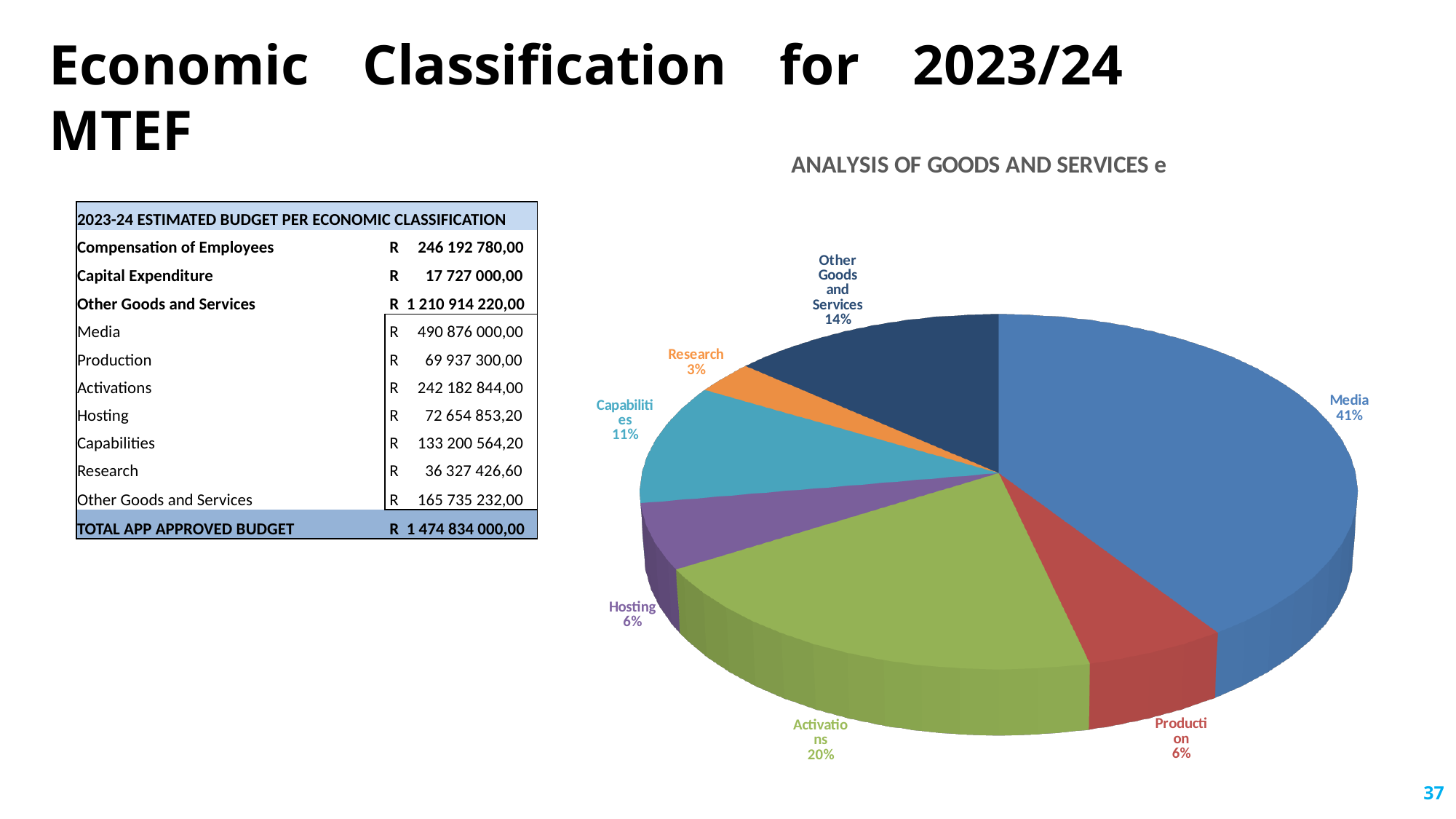
What share of the pie does Activations account for? 20% Which slice of the pie chart is the largest? Media Which slice of the pie chart is the smallest? Research What percentage is shown for Research in the pie chart? 3% What percentage is shown for Other Goods and Services in the pie chart? 14% What share of the pie does Media account for? 41% How many slices does the pie chart have? 7 What is the title of the pie chart? ANALYSIS OF GOODS AND SERVICES e What percentage is shown for Capabilities in the pie chart? 11% Which is larger in the pie chart, Capabilities or Other Goods and Services? Other Goods and Services What kind of chart is shown on the slide? Pie chart What is the difference in percentage points between Media and Activations in the pie chart? 21